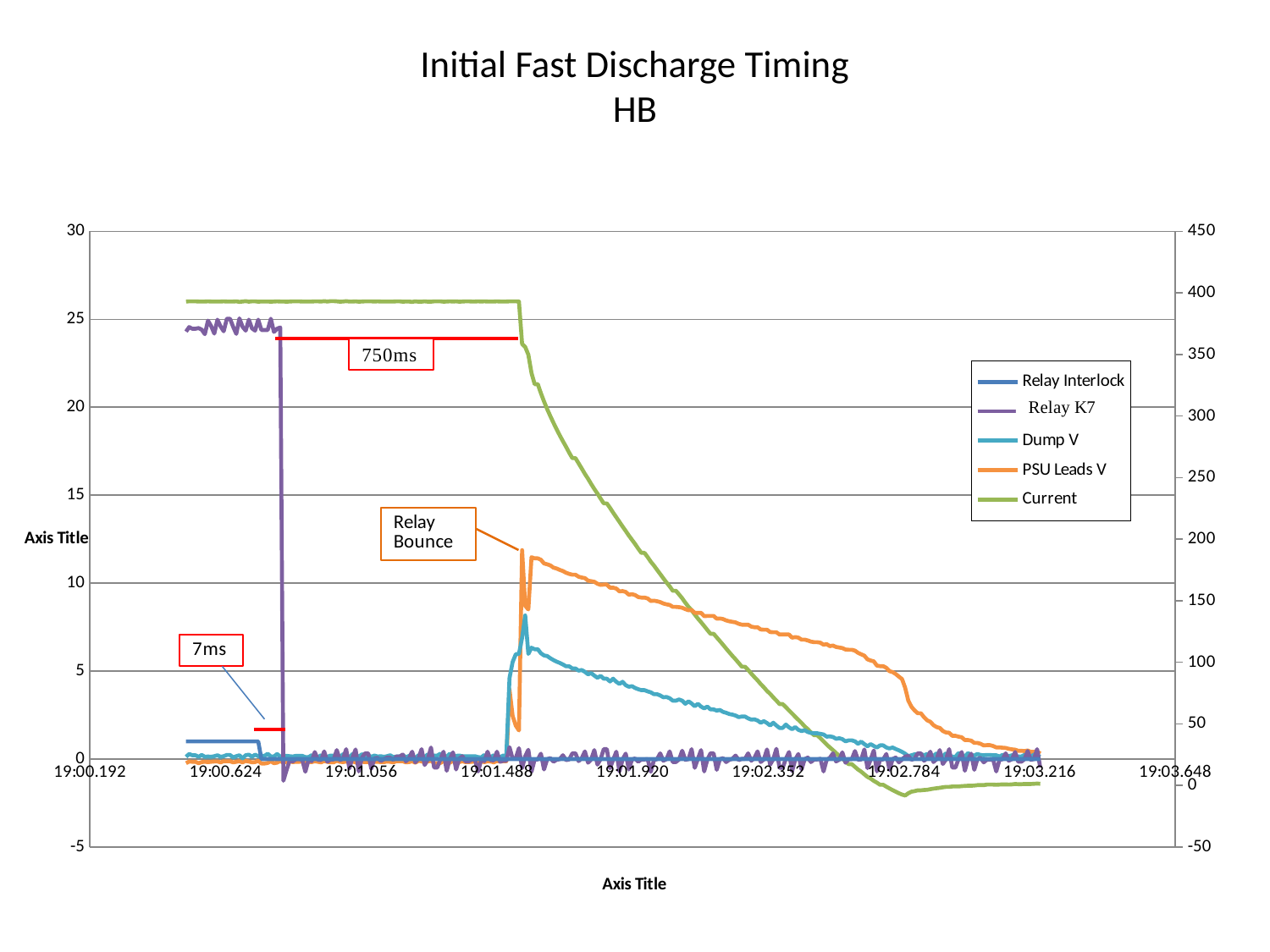
What is the last time label on the horizontal axis? 19:03.648 What kind of chart is shown on the slide? line chart What is the maximum value shown on the right vertical axis? 450 What is the first time label on the horizontal axis? 19:00.192 Reading against the right-hand axis, is the initial flat level of the Current line greater or less than 350? greater What duration is written in the red-boxed annotation next to the long red horizontal line? 750ms Does the Current line rise or fall between 19:01.488 and 19:02.784? fall What is the title of the chart? Initial Fast Discharge Timing HB How many series does the legend list? 5 What is the maximum value shown on the left vertical axis? 30 What duration is written in the red-boxed annotation near the Relay Interlock step? 7ms Which series is listed last in the legend? Current